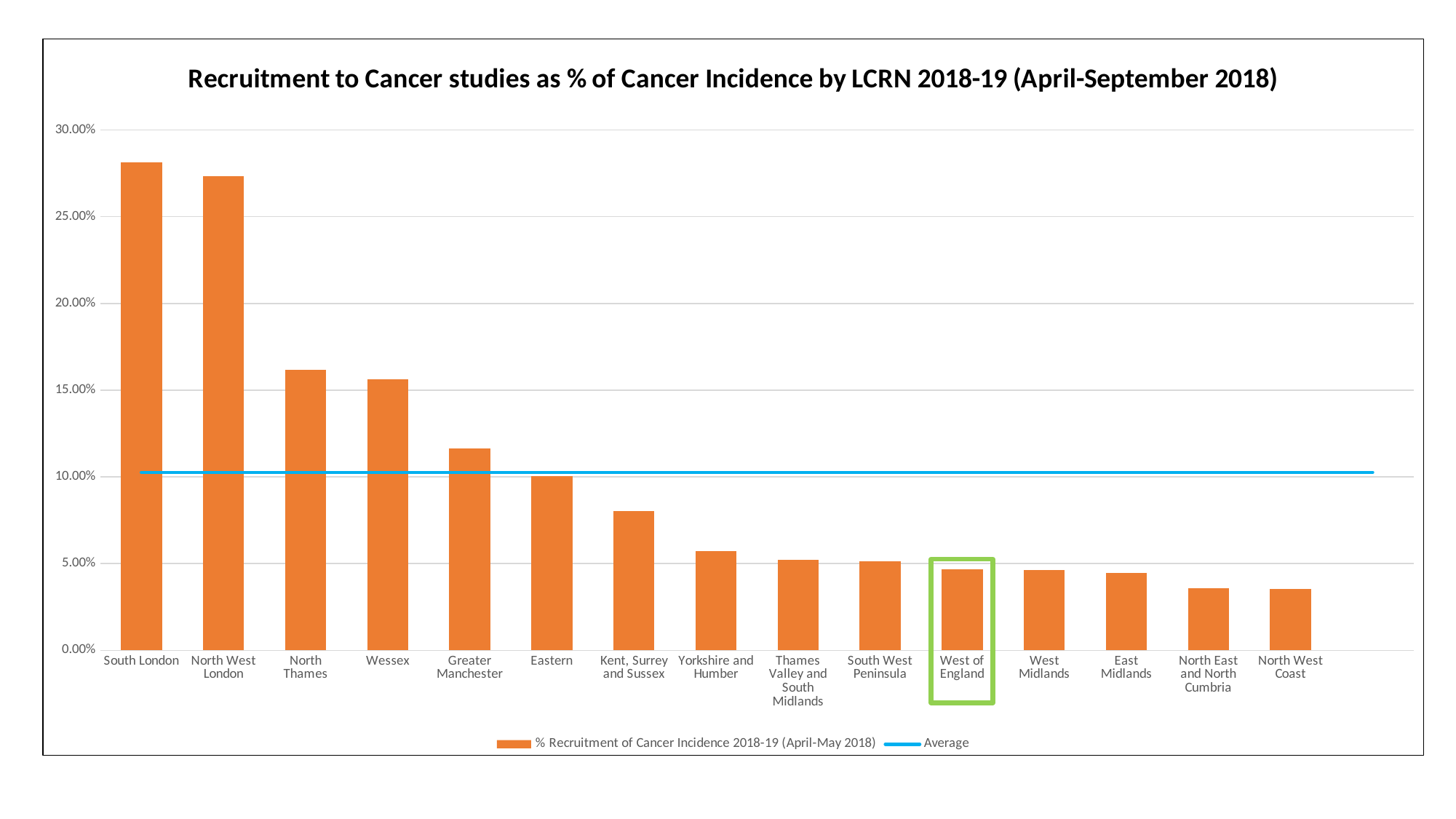
Is the value for West of England greater or less than 5.00%? less How many LCRN categories are shown on the x axis? 15 What does the blue horizontal line represent according to the legend? Average Is the value for Kent, Surrey and Sussex greater or less than 10.00%? less Is the value for Greater Manchester greater or less than 10.00%? greater Which LCRN has the highest recruitment as % of cancer incidence? South London Do the bar values rise or fall from left to right along the x axis? fall Which has a larger value, Greater Manchester or Eastern? Greater Manchester What kind of chart is shown on the slide? bar chart How many series does the legend list? 2